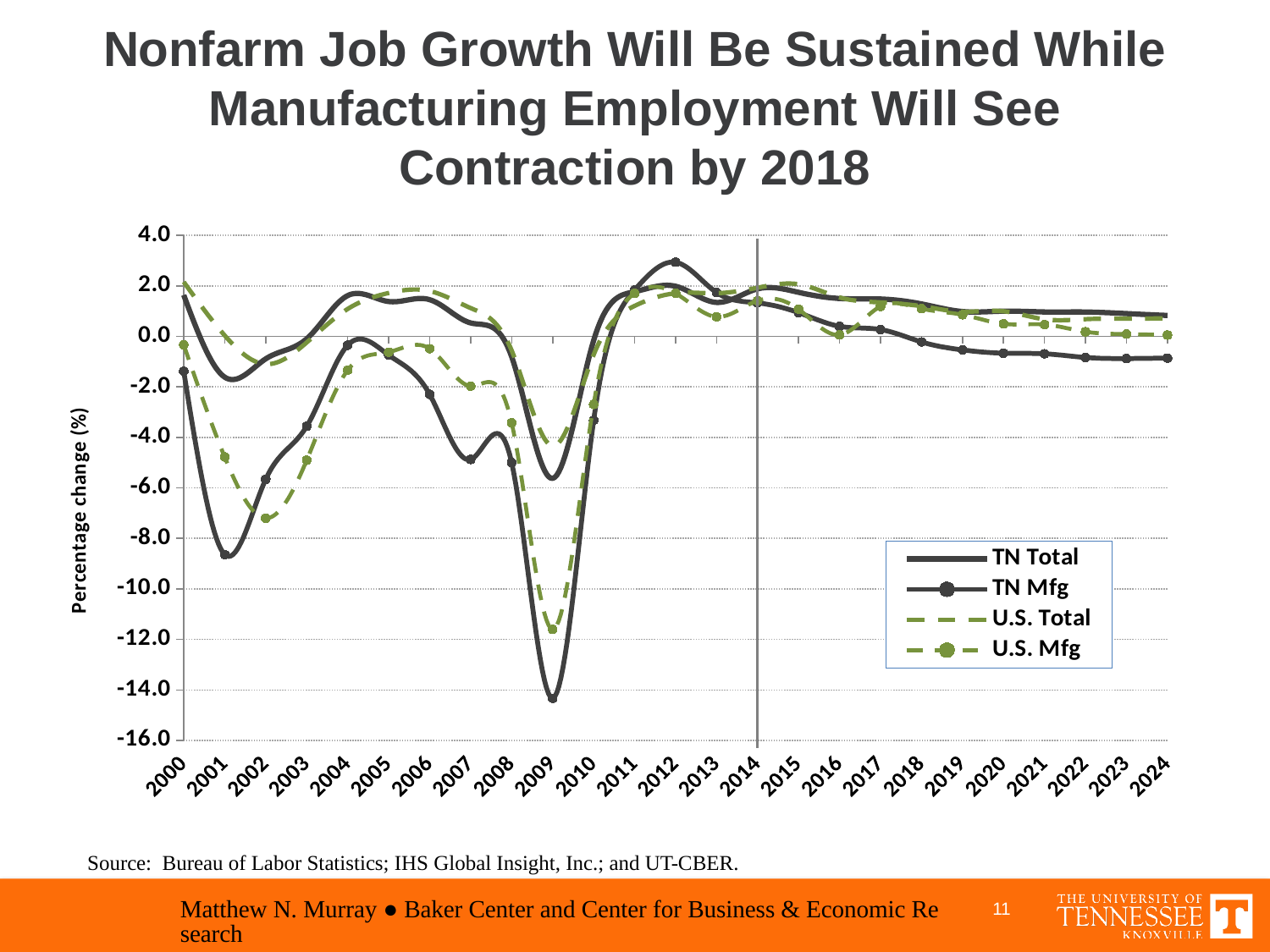
In which year does TN Mfg reach its lowest value? 2009 What is the label on the y axis? Percentage change (%) Is the value for TN Mfg in 2009 greater or less than -12.0? less Is the value for TN Mfg in 2001 greater or less than -8.0? less Does the TN Mfg line rise or fall from 2014 to 2024? fall Is the value for U.S. Mfg in 2009 greater or less than -10.0? less Which series has the lowest value in 2009? TN Mfg What kind of chart is shown on the slide? line chart In 2024, which is higher: TN Total or TN Mfg? TN Total How many years are shown on the x axis? 25 How many series does the legend list? 4